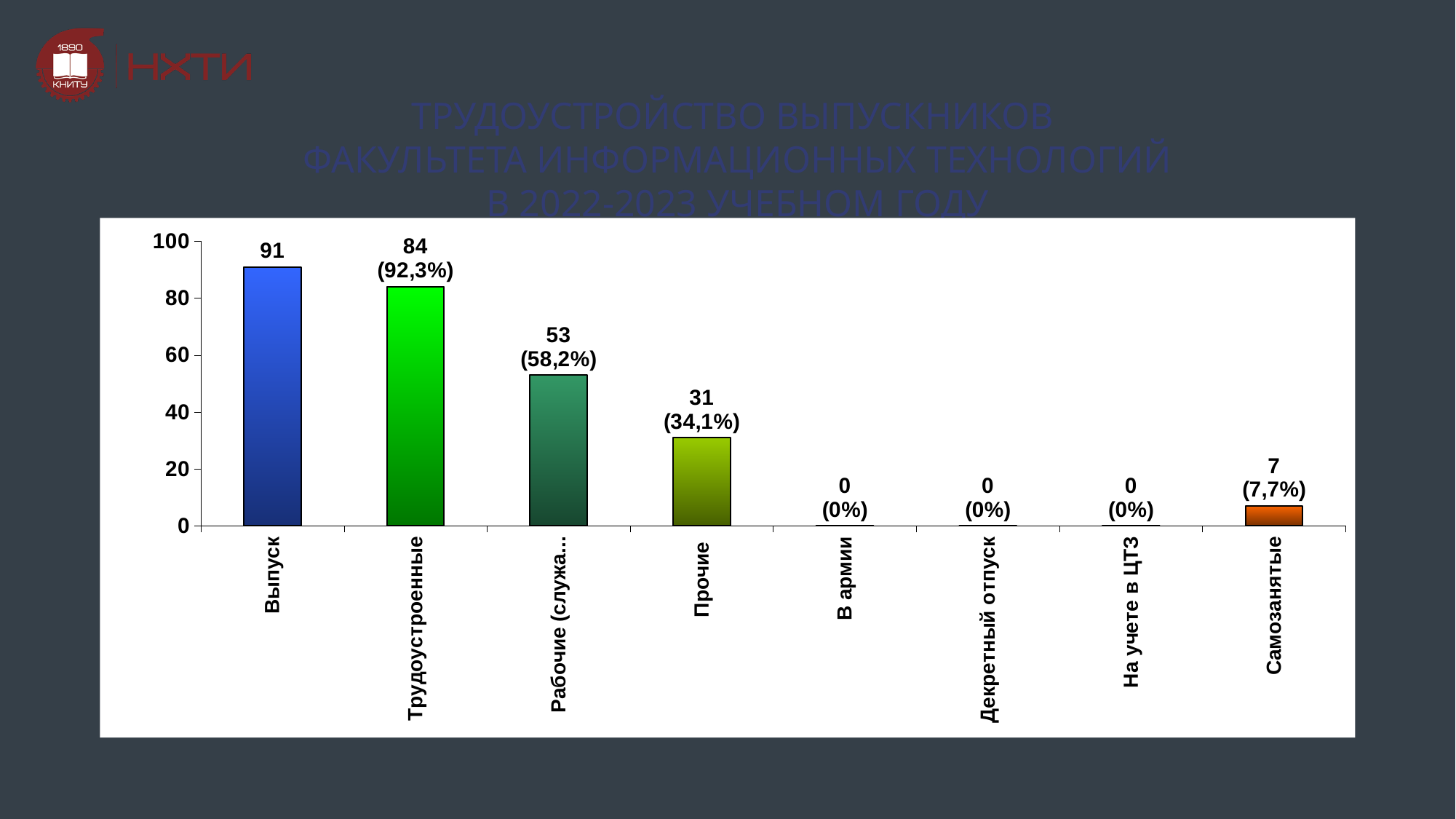
What type of chart is shown on the slide? bar chart What is the value for Прочие? 31 Which is larger, the value for Прочие or the value for Самозанятые? Прочие Which category has the highest value? Выпуск What percentage is shown for Самозанятые? 7,7% How many categories are shown on the x axis of the chart? 8 What percentage is shown for Трудоустроенные? 92,3% What is the difference between the values for Выпуск and Трудоустроенные? 7 What is the value for Выпуск? 91 What is the value for Трудоустроенные? 84 What is the value for В армии? 0 What is the value for Самозанятые? 7